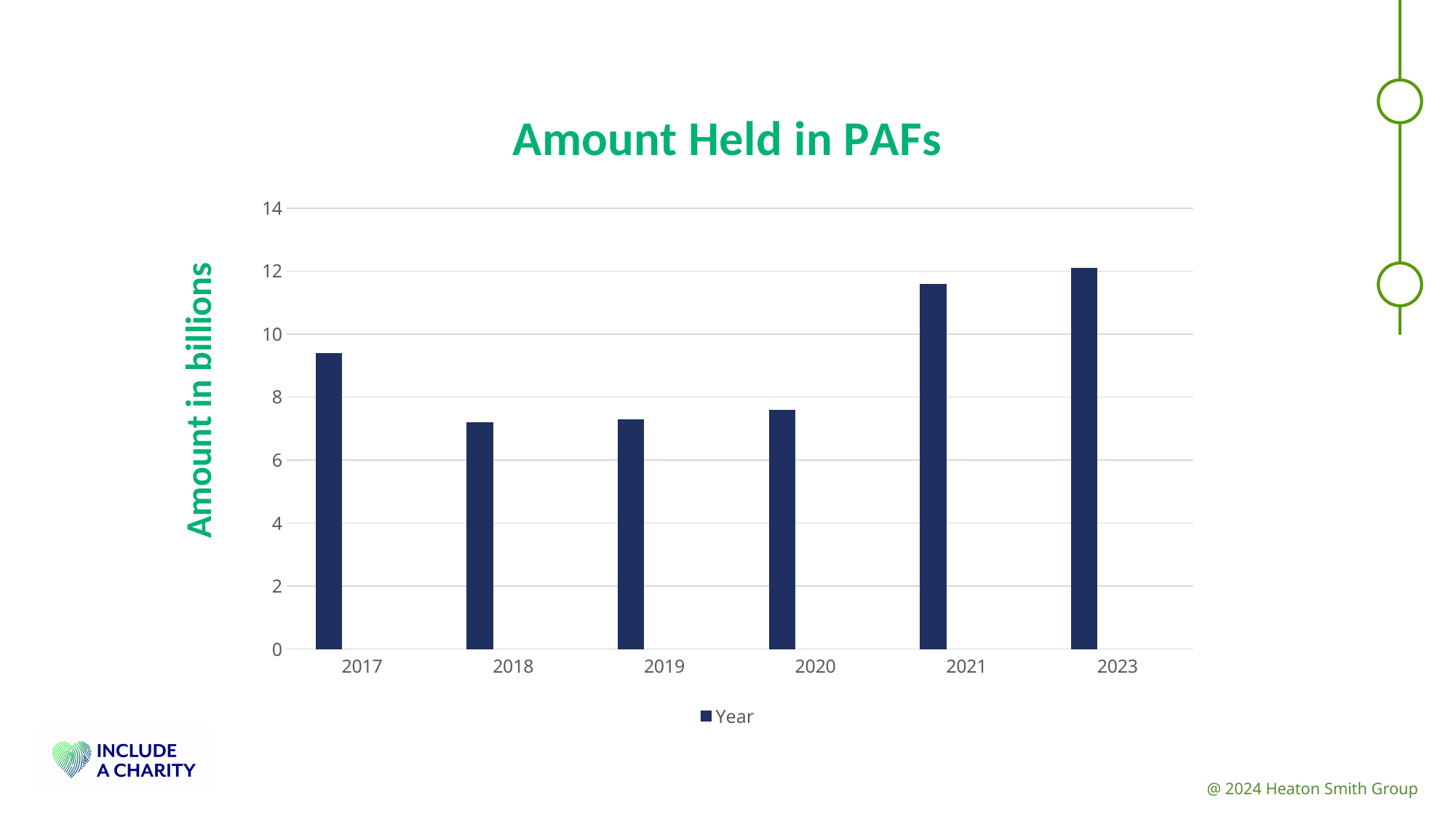
Is the value for 2017 greater or less than 8? greater What is the label on the vertical axis of the chart? Amount in billions Which is larger, the value for 2021 or the value for 2019? 2021 What is the title of the chart? Amount Held in PAFs Which is larger, the value for 2017 or the value for 2020? 2017 Is the value for 2018 greater or less than 8? less Which year has the highest amount held in PAFs? 2023 How many series does the legend list? 1 Is the value for 2020 greater or less than 8? less What type of chart is shown on the slide? Bar chart How many years are shown on the x axis of the chart? 6